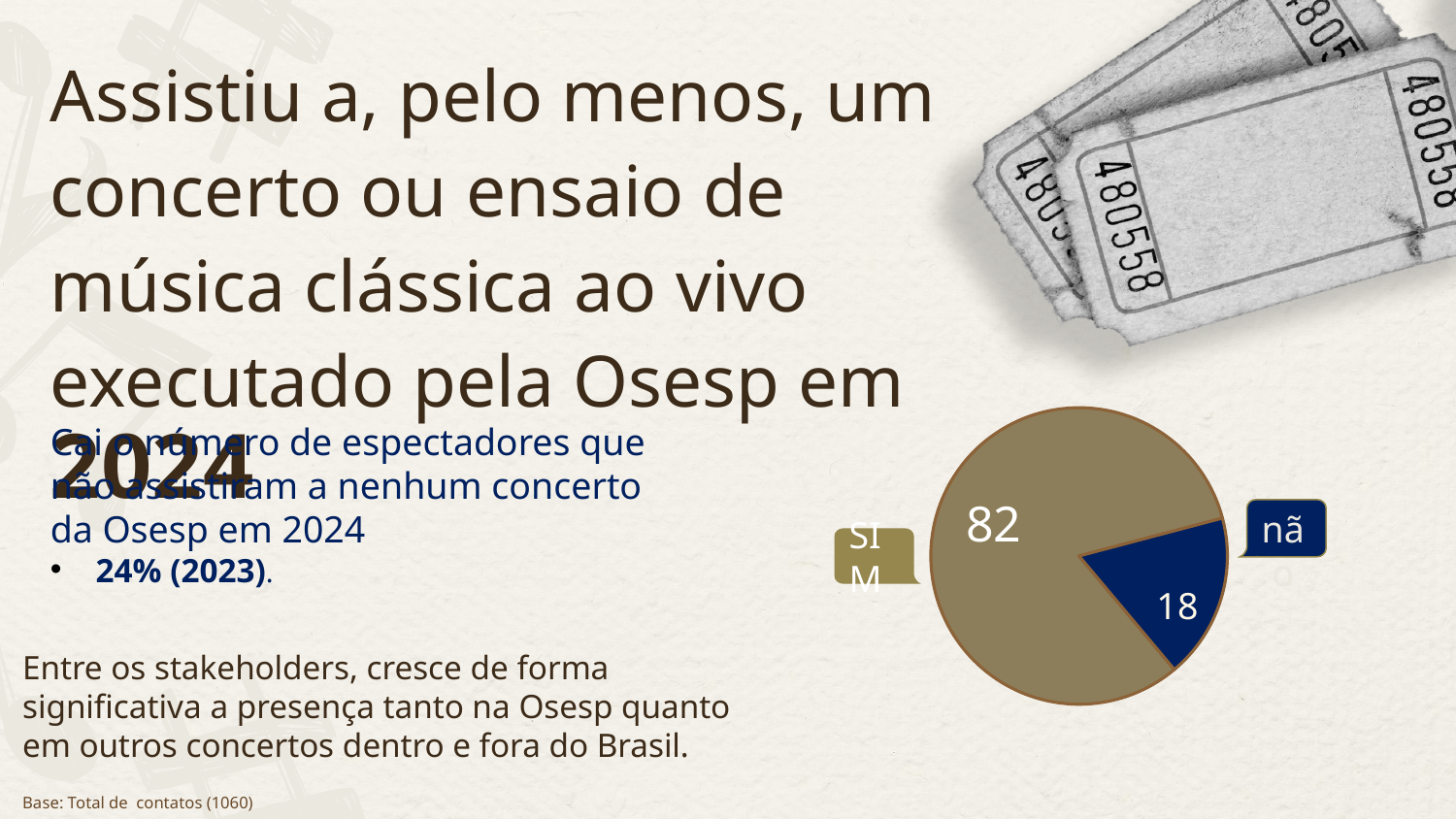
Which is larger in the pie chart, SIM or não? SIM Which slice of the pie chart is the smallest? não Which slice of the pie chart is coloured dark blue? não What is the difference between the SIM value and the não value in the pie chart? 64 What value is shown for the SIM slice of the pie chart? 82 Is the value for SIM in the pie chart greater or less than 50? greater What value is shown for the não slice of the pie chart? 18 How many slices does the pie chart have? 2 What is the total of the two values shown in the pie chart? 100 Which slice of the pie chart is the largest? SIM What share of the pie does the SIM slice represent? 82% What kind of chart is shown on the slide? pie chart